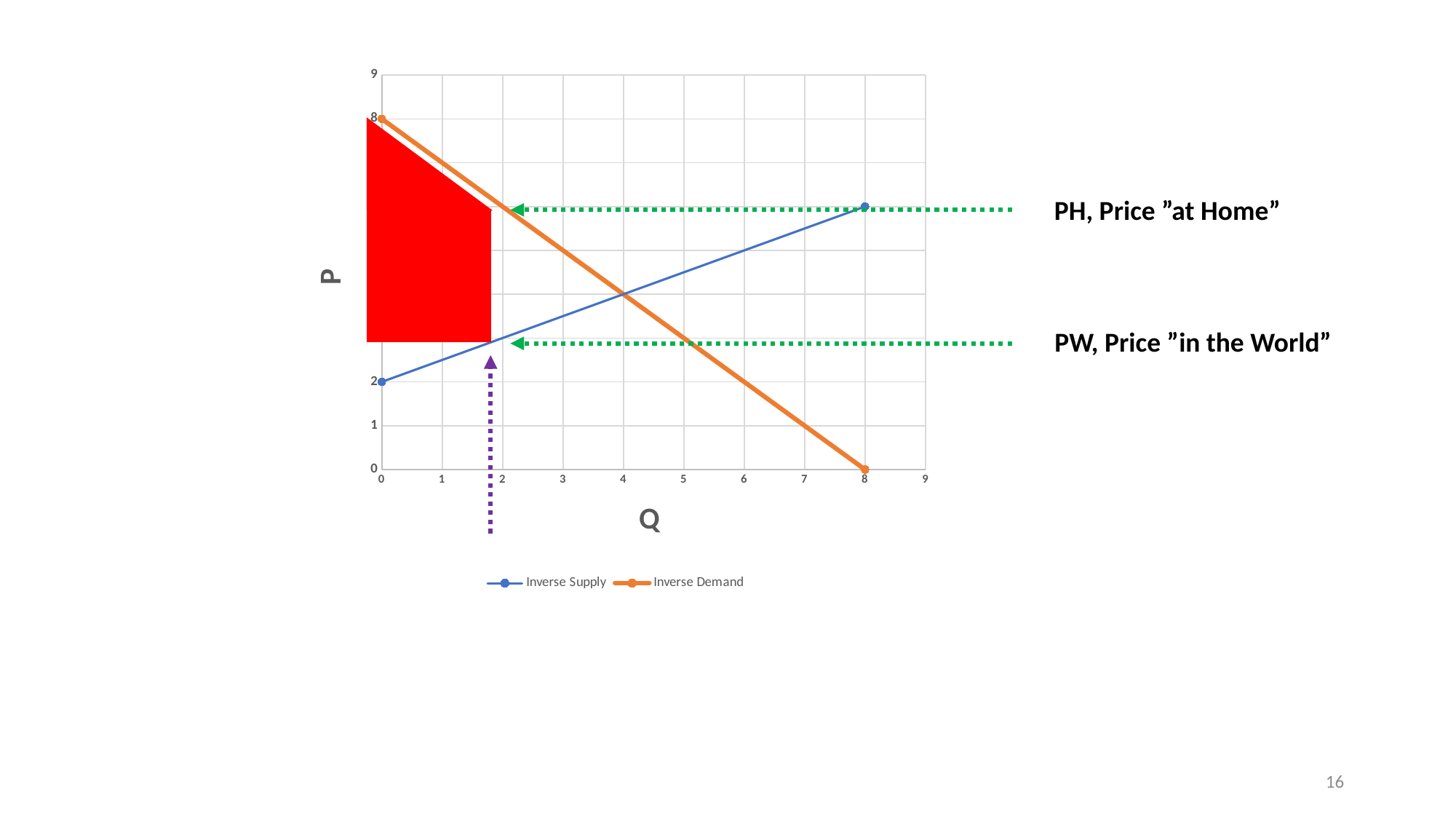
At Q = 0, what is the difference between the Inverse Demand value and the Inverse Supply value? 6 At Q = 8, which series has the higher value, Inverse Supply or Inverse Demand? Inverse Supply Is the value of Inverse Supply at Q = 8 greater or less than 8? less What is the value of Inverse Demand at Q = 8? 0 Does the Inverse Demand line rise or fall as Q increases? Falls How many series does the legend list? 2 What is the value of Inverse Demand at Q = 0? 8 At Q = 0, which series has the higher value, Inverse Supply or Inverse Demand? Inverse Demand What kind of chart is shown on the slide? Line chart What are the two series named in the legend? Inverse Supply and Inverse Demand Does the Inverse Supply line rise or fall as Q increases? Rises What is the value of Inverse Supply at Q = 0? 2